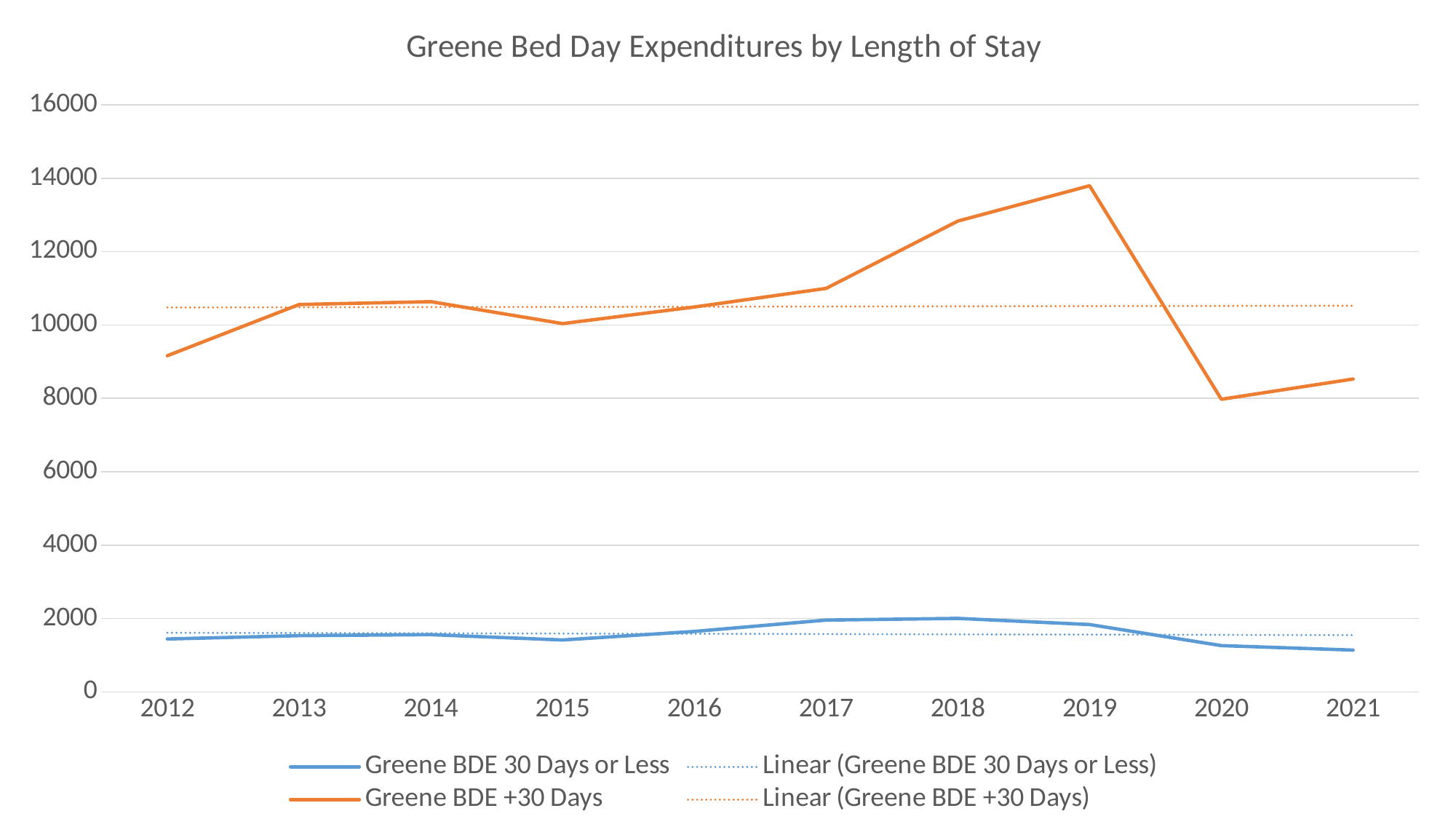
How many years are shown on the x axis? 10 How many entries does the legend list? 4 What is the title of the chart? Greene Bed Day Expenditures by Length of Stay Does the Greene BDE +30 Days series rise or fall from 2019 to 2020? Fall In which year does the Greene BDE 30 Days or Less series reach its lowest value? 2021 In which year does the Greene BDE +30 Days series reach its highest value? 2019 Is the value for Greene BDE +30 Days in 2020 greater or less than 10000? less Which is larger in 2015: Greene BDE +30 Days or Greene BDE 30 Days or Less? Greene BDE +30 Days In which year does the Greene BDE +30 Days series reach its lowest value? 2020 What type of chart is shown on the slide? Line chart Is the value for Greene BDE 30 Days or Less in 2018 greater or less than 4000? less Is the value for Greene BDE +30 Days in 2019 greater or less than 12000? greater